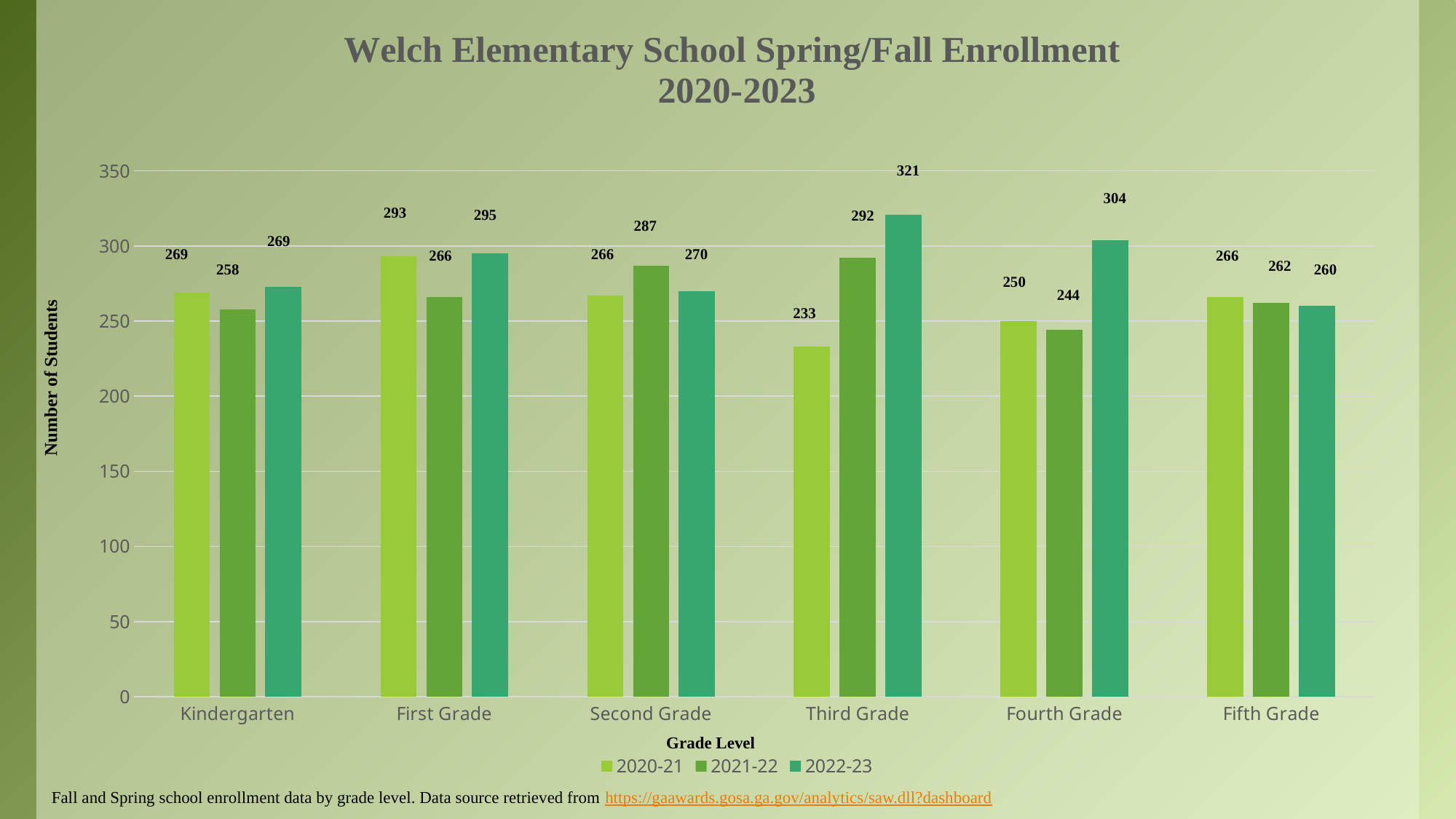
Do the Fifth Grade enrollment values rise or fall from 2020-21 to 2022-23? fall Which grade level has the highest enrollment in the 2022-23 series? Third Grade Is the value for Fourth Grade in 2022-23 greater or less than 300? greater What is the difference between Third Grade enrollment in 2022-23 and in 2020-21? 88 Which grade level has the lowest enrollment in the 2020-21 series? Third Grade How many series does the legend list? 3 What is the title of the chart? Welch Elementary School Spring/Fall Enrollment 2020-2023 Which is larger: First Grade enrollment in 2020-21 or Second Grade enrollment in 2020-21? First Grade How many grade levels are shown on the x axis? 6 What kind of chart is shown on the slide? bar chart What is the enrollment for Third Grade in 2022-23? 321 What is the enrollment for Fourth Grade in 2021-22? 244